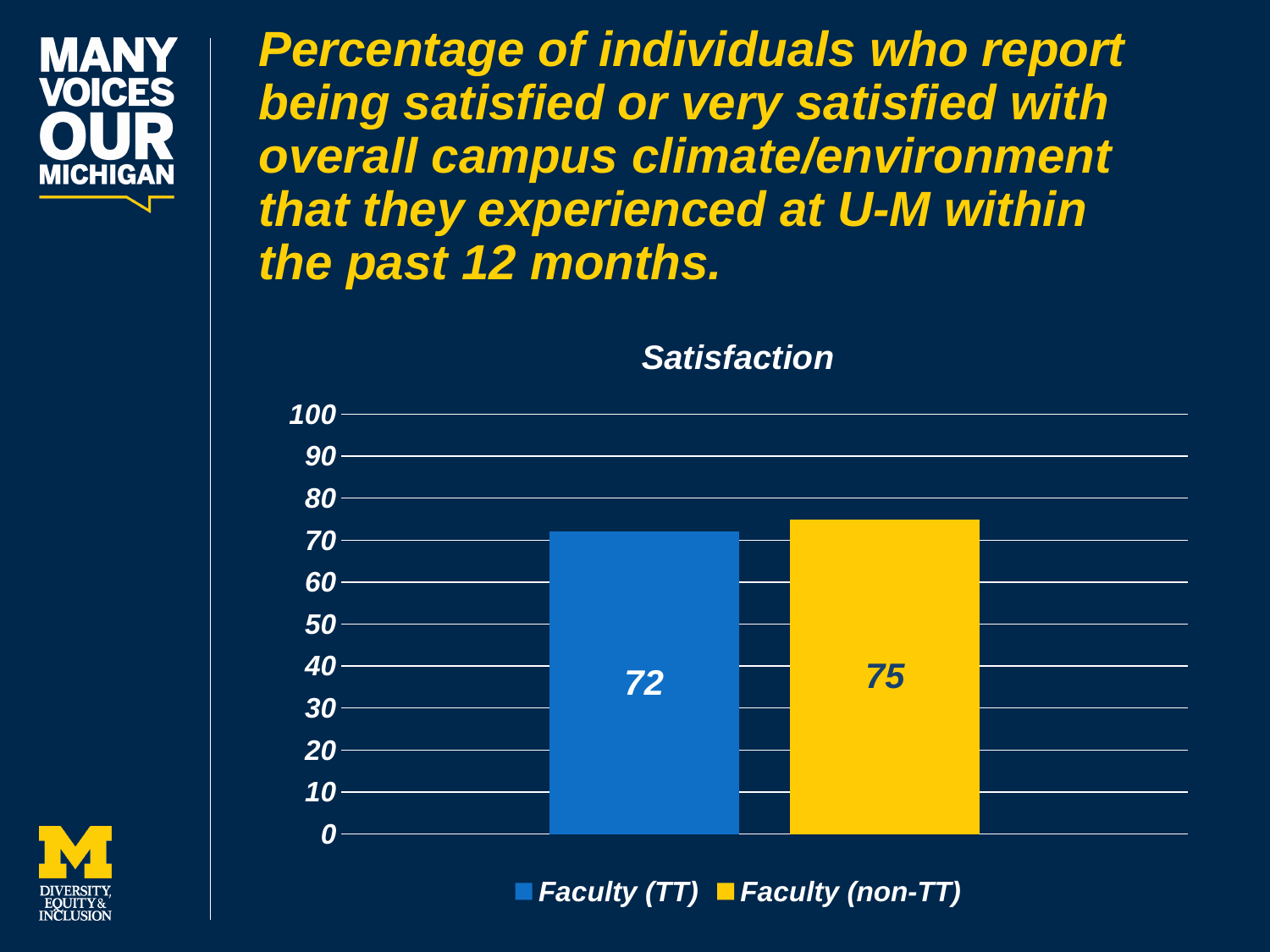
What is the difference between the Faculty (non-TT) value and the Faculty (TT) value? 3 What kind of chart is shown? bar chart Is the value for Faculty (TT) greater or less than 80? less What is the value for Faculty (non-TT)? 75 What colour is the Faculty (non-TT) bar? yellow What is the value for Faculty (TT)? 72 Is the value for Faculty (non-TT) greater or less than 70? greater How many series does the legend list? 2 What is the title of the chart? Satisfaction What is the maximum value shown on the vertical axis? 100 Which series has the lowest value? Faculty (TT) Which series has the higher value, Faculty (TT) or Faculty (non-TT)? Faculty (non-TT)